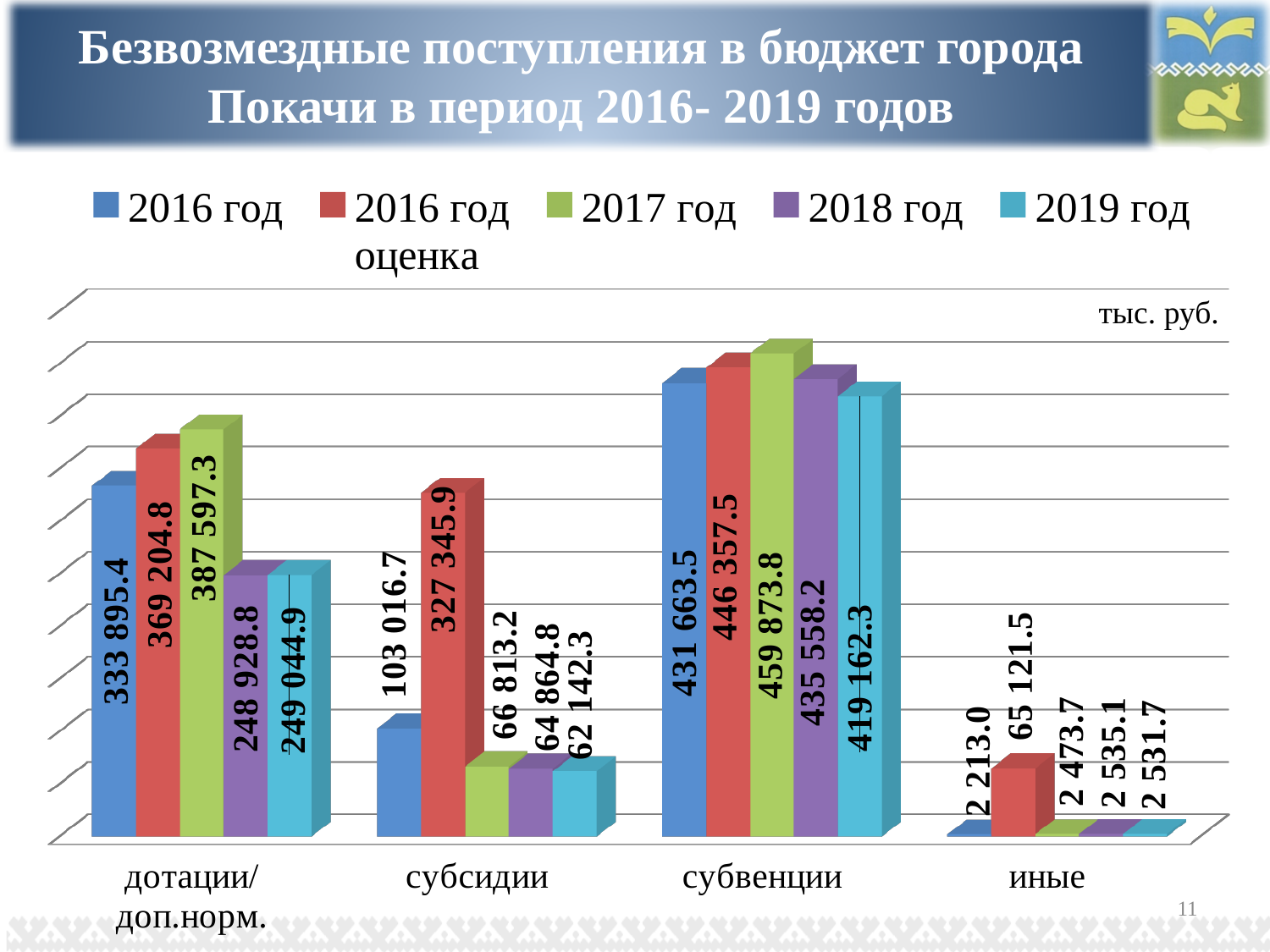
Which is larger for субсидии: the 2016 год value or the 2017 год value? 2016 год Which category has the highest value in the 2019 год series? субвенции What is the difference between the 2017 год and 2018 год values for дотации/доп.норм.? 138 668.5 What is the value for субсидии in the 2016 год оценка series? 327 345.9 Which category has the lowest value in the 2017 год series? иные What is the value for дотации/доп.норм. in the 2018 год series? 248 928.8 How many series does the legend list? 5 What is the value for субвенции in the 2017 год series? 459 873.8 What type of chart is shown on the slide? bar chart What is the value for иные in the 2019 год series? 2 531.7 How many categories are shown on the x axis? 4 What unit is indicated in the top right corner of the chart area? тыс. руб.